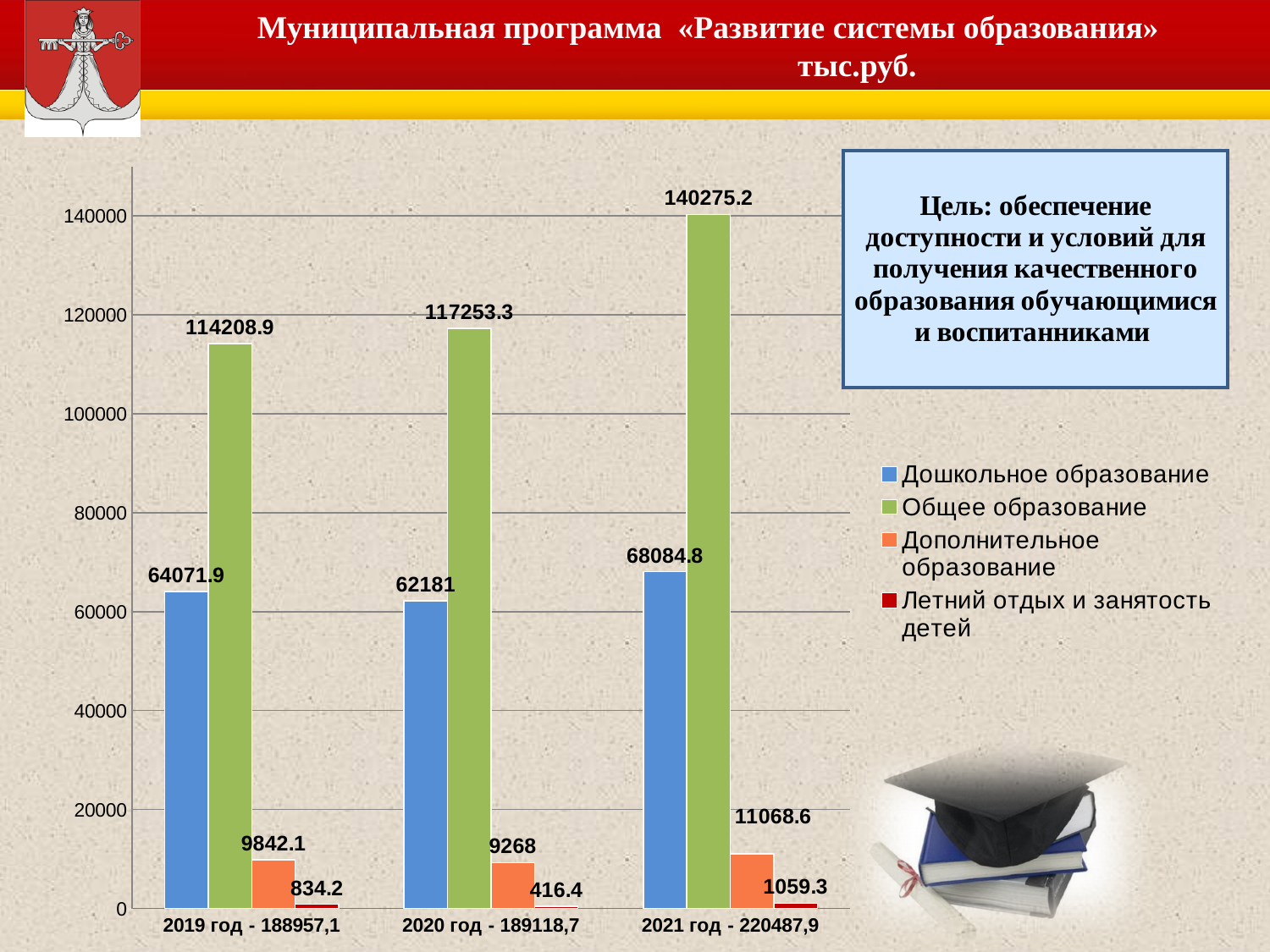
What is the value for Летний отдых и занятость детей in 2021 год? 1059.3 What kind of chart is shown on the slide? Bar chart What is the value for Общее образование in 2021 год? 140275.2 Which is larger: Дошкольное образование in 2019 год or in 2020 год? 2019 год What is the value for Дошкольное образование in 2020 год? 62181 What is the difference between the Общее образование values for 2021 год and 2020 год? 23021.9 How many year categories are shown on the x axis? 3 How many series does the legend list? 4 What is the value for Дополнительное образование in 2019 год? 9842.1 In which year is the value for Общее образование the highest? 2021 год In which year is the value for Летний отдых и занятость детей the lowest? 2020 год Does the value for Общее образование rise or fall from 2019 год to 2021 год? Rise